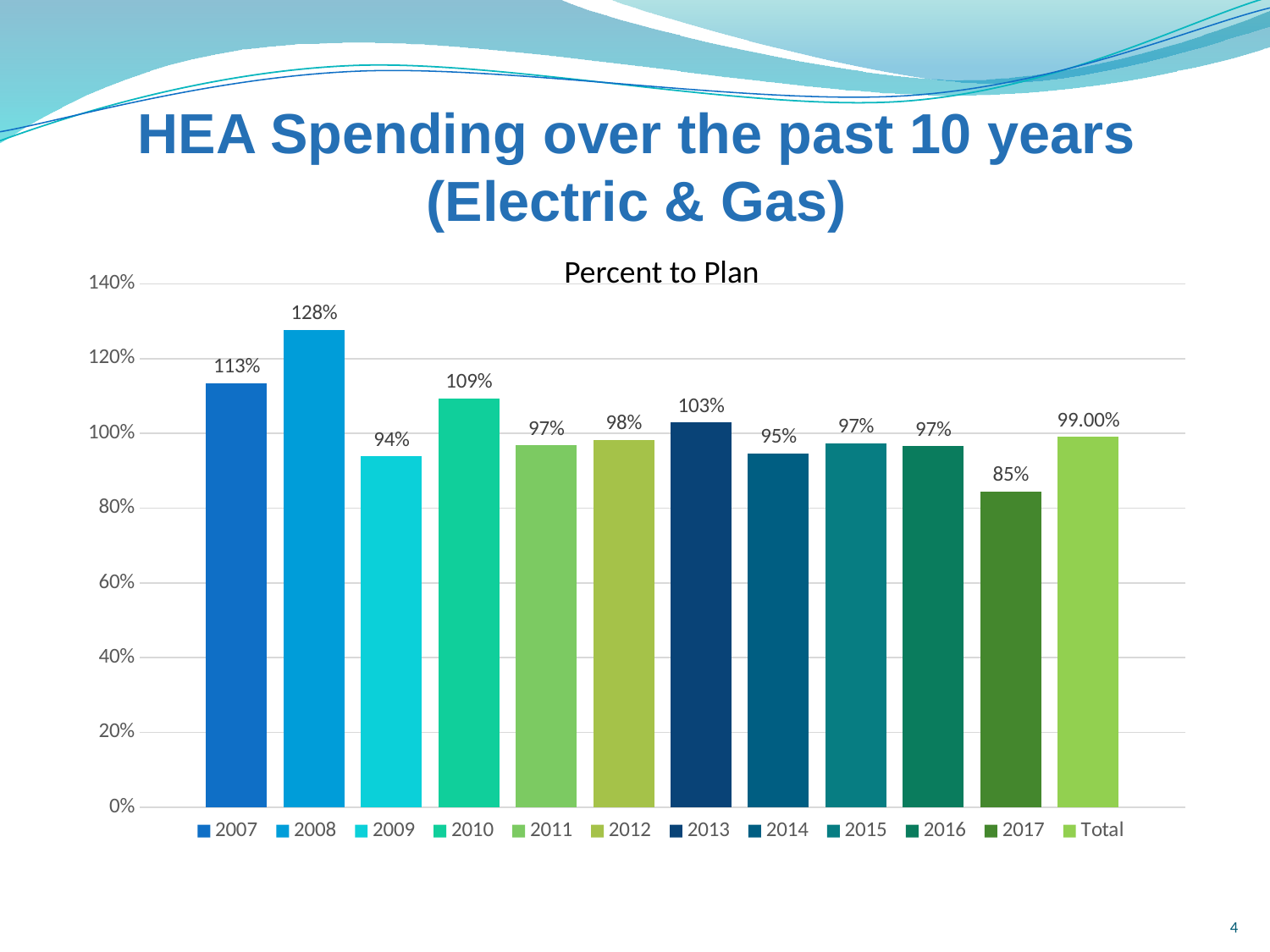
How many entries does the legend list? 12 How many bars are shown in the chart? 12 Which has a higher Percent to Plan, 2010 or 2013? 2010 What is the difference between the Percent to Plan values for 2008 and 2017? 43% Which year has the lowest Percent to Plan? 2017 What is the Percent to Plan value for Total? 99.00% What is the Percent to Plan value for 2017? 85% What type of chart is shown on the slide? Bar chart What is the Percent to Plan value for 2008? 128% Which year has the highest Percent to Plan? 2008 Is the Percent to Plan value for 2007 greater or less than 100%? greater What is the title of the chart? Percent to Plan